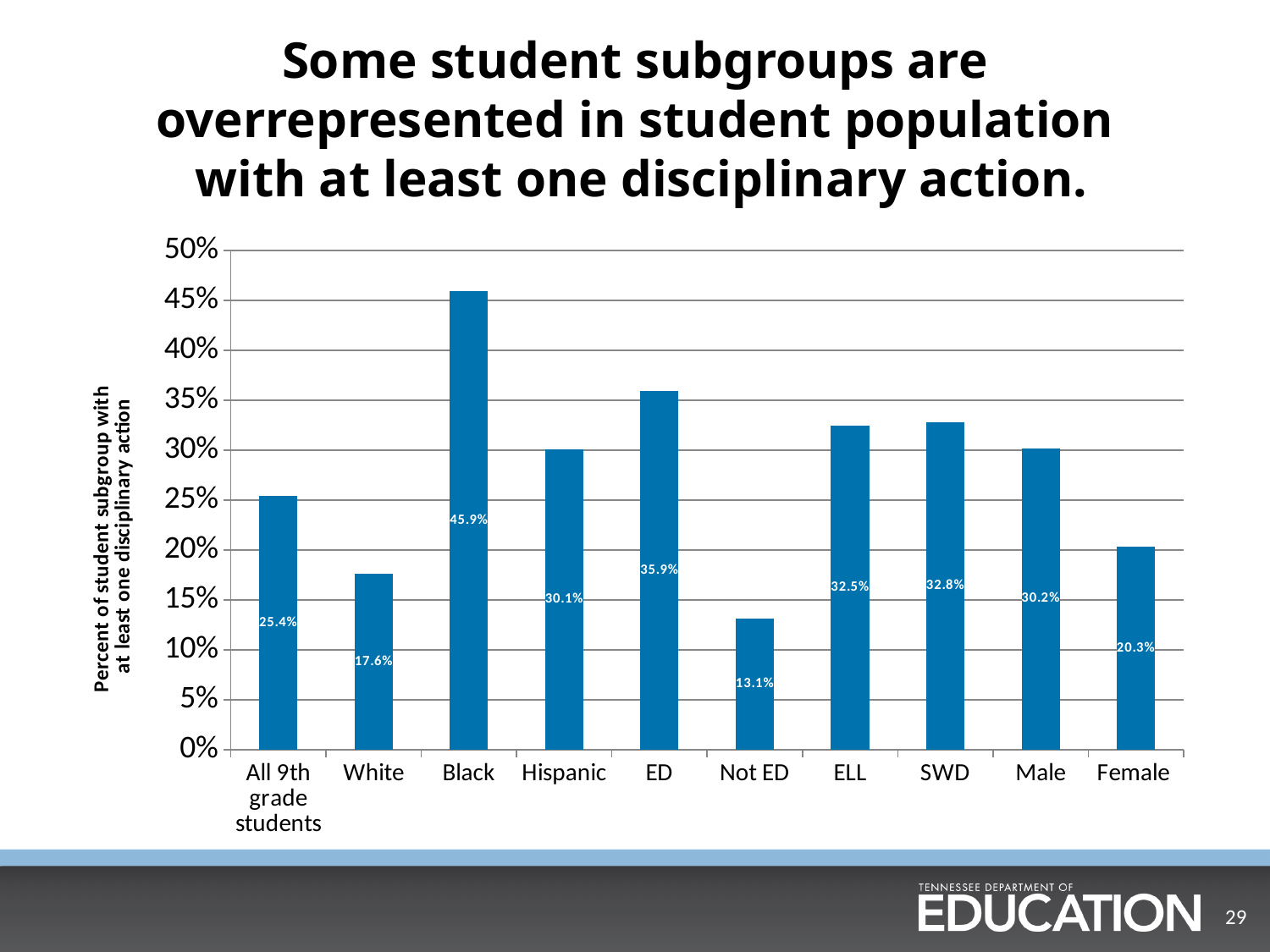
What is the value for Not ED students? 13.1% How many subgroups are shown on the x axis? 10 What is the value for All 9th grade students? 25.4% What is the label of the vertical axis? Percent of student subgroup with at least one disciplinary action Is the value for White greater or less than 20%? less What kind of chart is shown on the slide? bar chart What is the difference between the values for ED and Not ED? 22.8% What is the value for SWD? 32.8% Which subgroup has the highest percentage? Black What is the value for Black students? 45.9% Which is larger, the value for Male or the value for Female? Male Which subgroup has the lowest percentage? Not ED